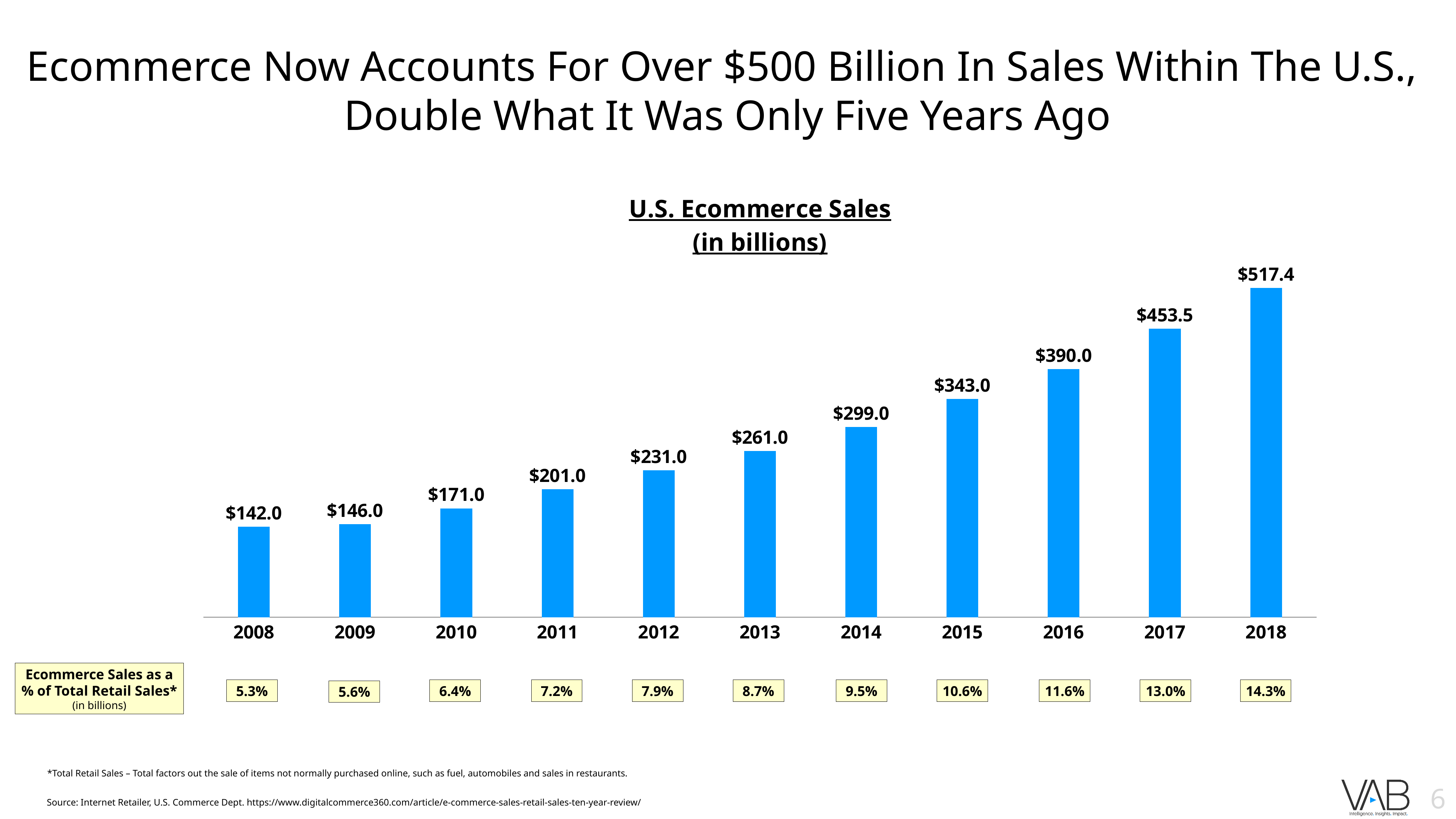
What is the value for 2014 in the U.S. Ecommerce Sales chart? $299.0 What is the value for 2008 in the U.S. Ecommerce Sales chart? $142.0 Which is larger in the U.S. Ecommerce Sales chart, the value for 2011 or the value for 2012? 2012 What is the title of the chart on the slide? U.S. Ecommerce Sales (in billions) What is the value for 2017 in the U.S. Ecommerce Sales chart? $453.5 Do the values in the U.S. Ecommerce Sales chart rise or fall from 2008 to 2018? Rise What kind of chart is the U.S. Ecommerce Sales chart? Bar chart What is the difference between the 2018 and 2013 values in the U.S. Ecommerce Sales chart? $256.4 How many years are shown in the U.S. Ecommerce Sales chart? 11 Which year has the highest value in the U.S. Ecommerce Sales chart? 2018 Which year has the lowest value in the U.S. Ecommerce Sales chart? 2008 What is the difference between the 2016 and 2015 values in the U.S. Ecommerce Sales chart? $47.0